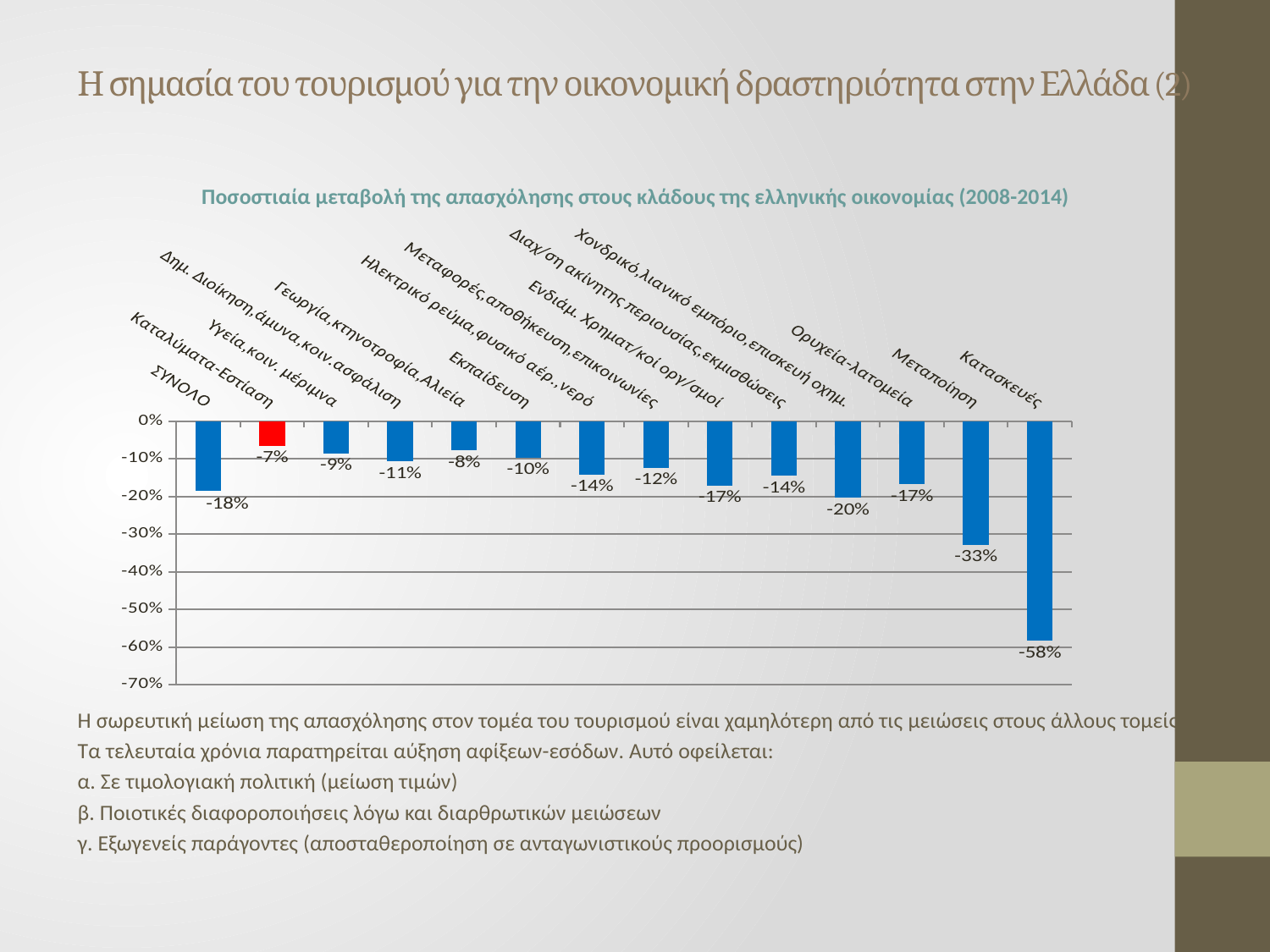
Which category has the highest value (smallest decline)? Καταλύματα-Εστίαση What is the value shown for Κατασκευές? -58% What is the difference in percentage points between the values for Κατασκευές and Μεταποίηση? 25 percentage points What is the value shown for Μεταποίηση? -33% How many categories are shown in the chart? 14 What is the value shown for Εκπαίδευση? -10% Which category's bar is coloured red instead of blue? Καταλύματα-Εστίαση What is the value shown for ΣΥΝΟΛΟ? -18% What kind of chart is shown on the slide? Bar chart Which category has the lowest value (largest decline)? Κατασκευές Which has the larger value, Εκπαίδευση or Μεταποίηση? Εκπαίδευση What is the value shown for Καταλύματα-Εστίαση? -7%